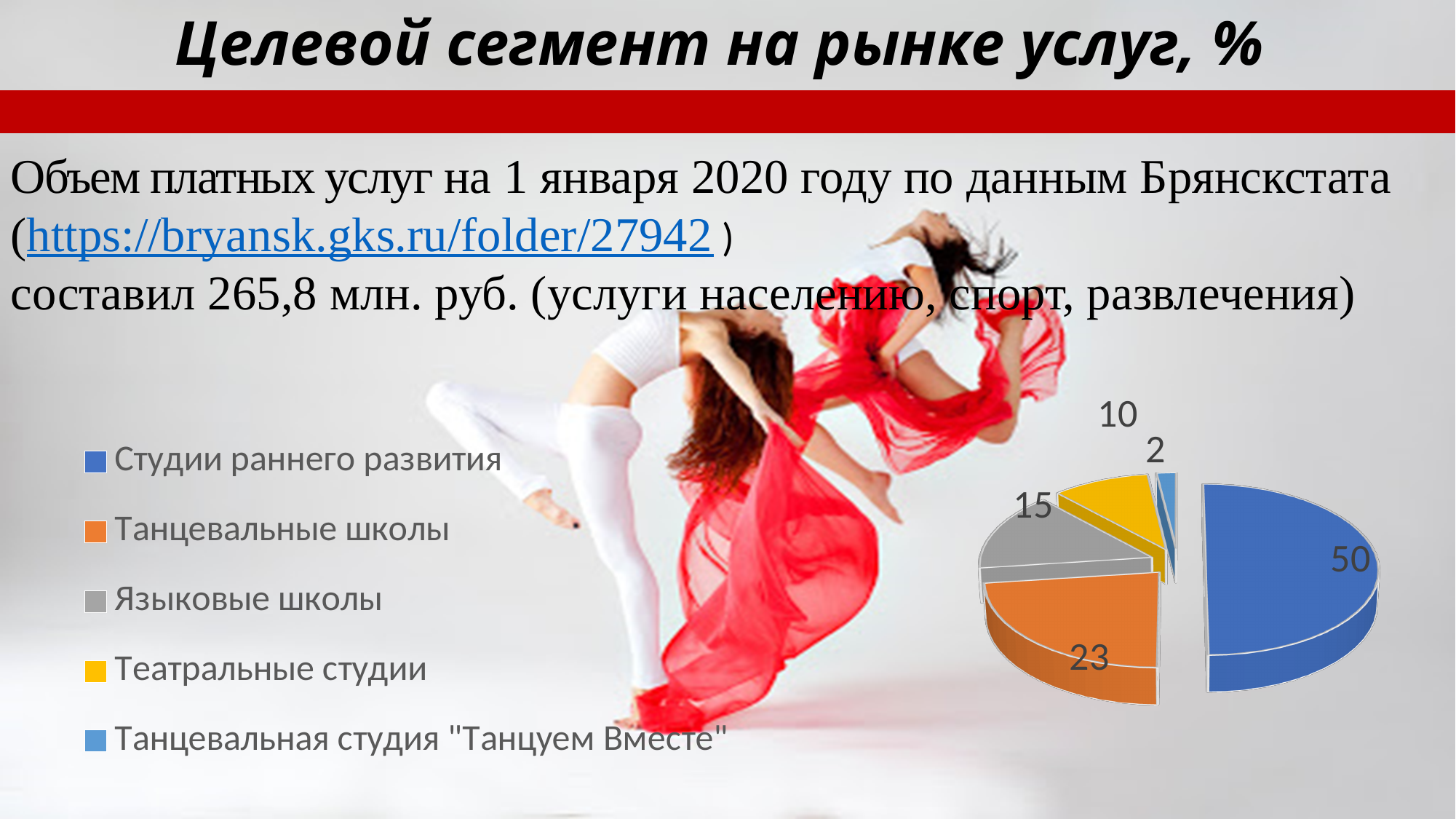
What is the value for Театральные студии? 10 Which category has the largest slice of the pie? Студии раннего развития How many categories does the pie chart have? 5 What colour is the slice for Танцевальные школы? orange Which is larger, the value for Языковые школы or the value for Театральные студии? Языковые школы What is the value for Танцевальная студия "Танцуем Вместе"? 2 What kind of chart is shown on the slide? pie chart What is the value for Танцевальные школы? 23 Which category has the smallest slice of the pie? Танцевальная студия "Танцуем Вместе" What is the difference between the values for Студии раннего развития and Танцевальные школы? 27 What is the value for Языковые школы? 15 What is the value for Студии раннего развития? 50